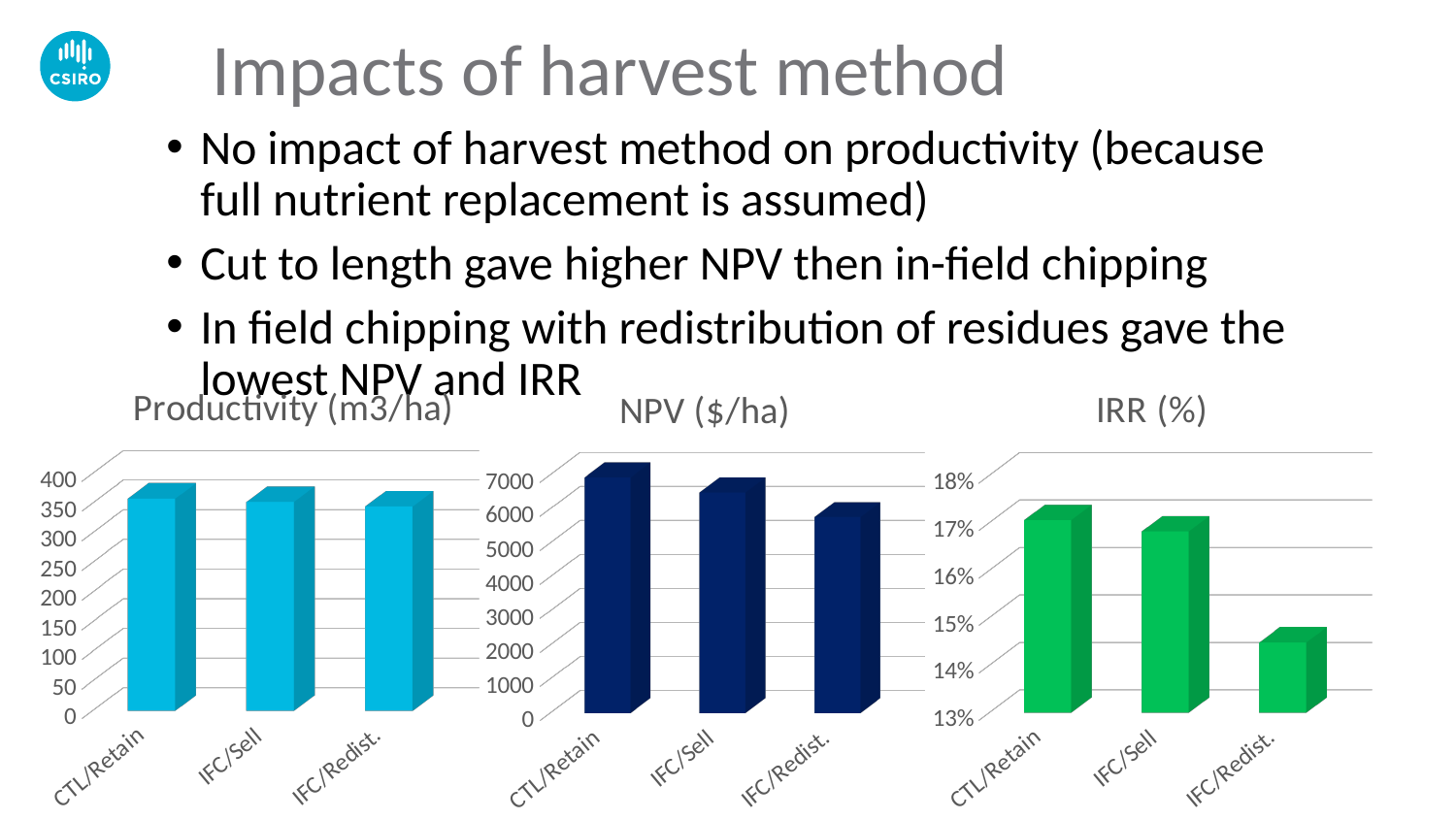
In the NPV ($/ha) chart, is the value for IFC/Redist. greater or less than 7000? less In the NPV ($/ha) chart, do the values rise or fall from CTL/Retain to IFC/Redist.? fall In the IRR (%) chart, is the value for IFC/Redist. greater or less than 15%? less In the Productivity (m3/ha) chart, is the value for CTL/Retain greater or less than 300? greater In the NPV ($/ha) chart, which category has the highest value? CTL/Retain In the IRR (%) chart, which category has the lowest value? IFC/Redist. What is the title of the rightmost chart on the slide? IRR (%) How many charts are shown on the slide? 3 How many categories are shown on the x axis of the Productivity (m3/ha) chart? 3 In the NPV ($/ha) chart, which category has the lowest value? IFC/Redist. What kind of chart is the NPV ($/ha) chart? bar chart